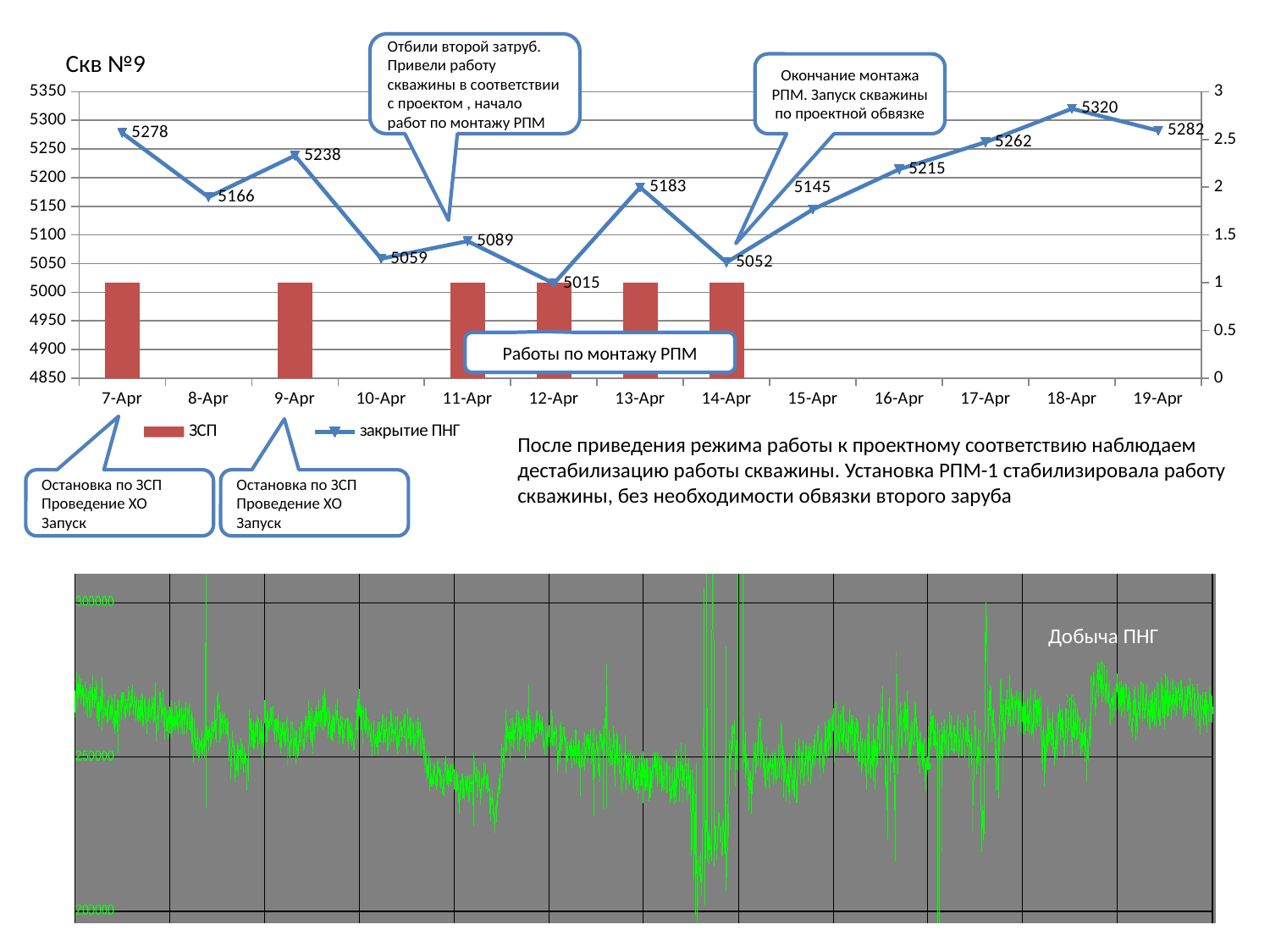
In the top chart 'Скв №9', on which date does 'закрытие ПНГ' reach its lowest value? 12-Apr In the top chart 'Скв №9', what is the difference between the 'закрытие ПНГ' values on 18-Apr and 12-Apr? 305 In the top chart 'Скв №9', what is the value of 'закрытие ПНГ' on 7-Apr? 5278 In the top chart 'Скв №9', how many dates are shown on the x axis? 13 In the top chart 'Скв №9', how many series does the legend list? 2 In the top chart 'Скв №9', how many 'ЗСП' bars are plotted? 6 In the top chart 'Скв №9', which is larger: the 'закрытие ПНГ' value on 9-Apr or on 13-Apr? 9-Apr What is the title of the top chart? Скв №9 In the top chart 'Скв №9', what is the value of 'закрытие ПНГ' on 14-Apr? 5052 In the top chart 'Скв №9', what is the value of 'закрытие ПНГ' on 16-Apr? 5215 In the top chart 'Скв №9', does the 'закрытие ПНГ' value rise or fall from 14-Apr to 18-Apr? rise In the top chart 'Скв №9', on which date does 'закрытие ПНГ' reach its highest value? 18-Apr